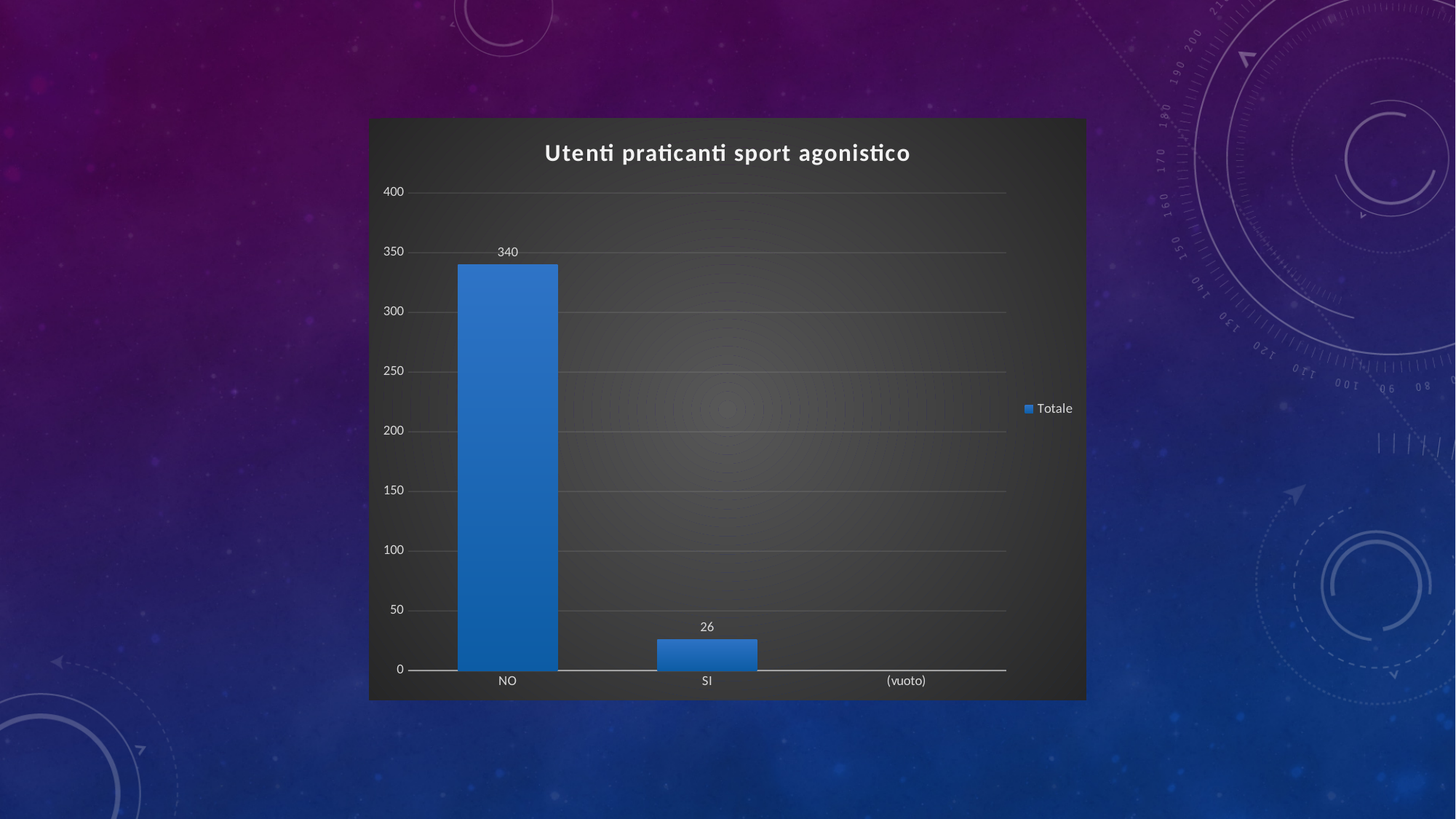
What is the value for SI? 26 What is the value for NO? 340 Which is larger, the value for NO or the value for SI? NO How many categories are shown on the x axis? 3 What is the difference between the values for NO and SI? 314 Which of the two labelled bars, NO or SI, has the lower value? SI Which category has the highest value? NO What kind of chart is shown? bar chart How many series does the legend list? 1 Is the value for NO greater or less than 300? greater Is the value for SI greater or less than 50? less What is the title of the chart? Utenti praticanti sport agonistico